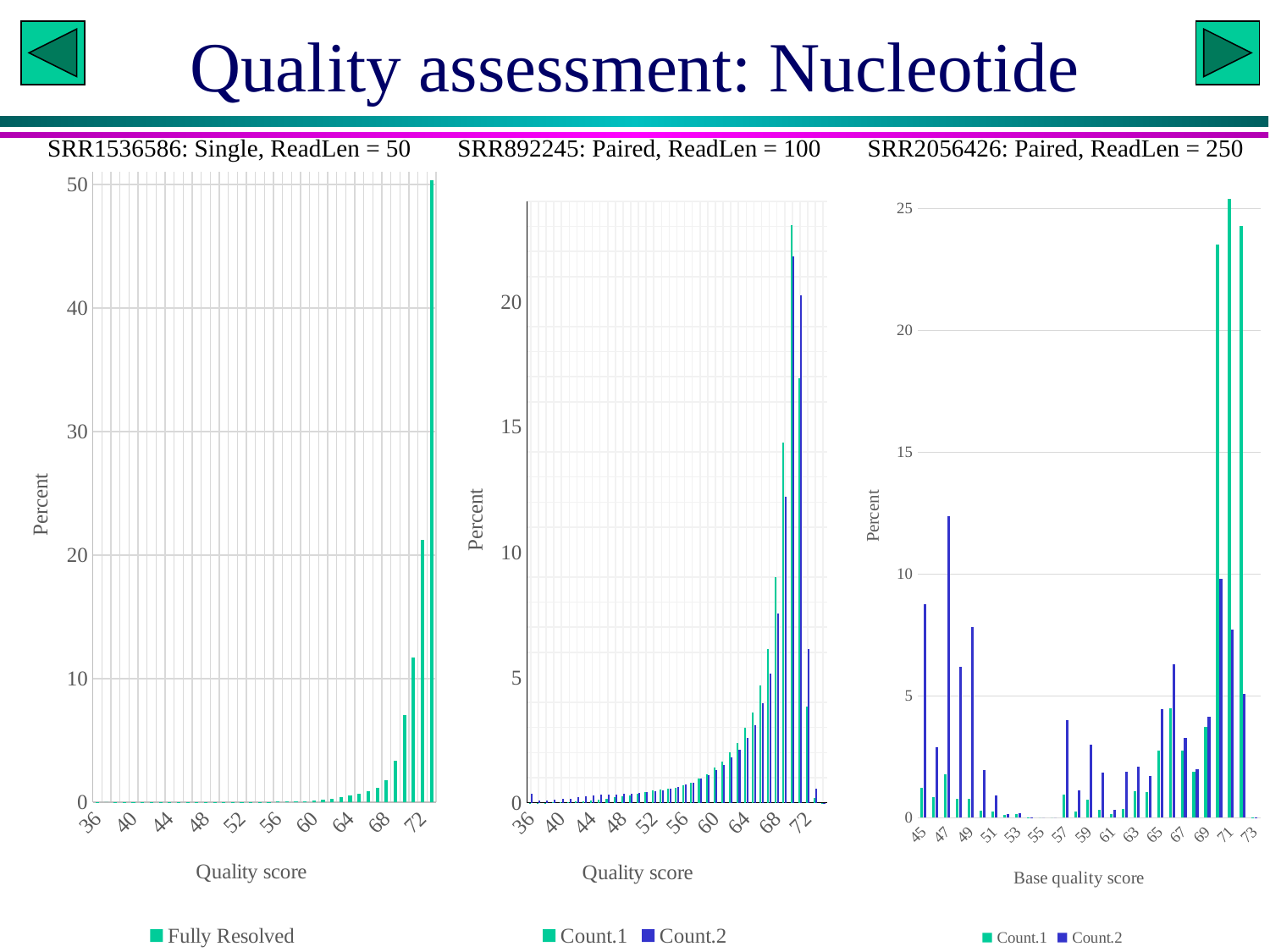
What kind of chart is the SRR1536586: Single, ReadLen = 50 chart? bar chart How many series does the legend of the SRR892245: Paired, ReadLen = 100 chart list? 2 What are the legend entries of the SRR2056426: Paired, ReadLen = 250 chart? Count.1 and Count.2 In the SRR1536586: Single, ReadLen = 50 chart, is the tallest bar greater or less than 40? greater In the SRR2056426: Paired, ReadLen = 250 chart, is the Count.2 value at quality score 47 greater or less than 10? greater In the SRR1536586: Single, ReadLen = 50 chart, do the bar values generally rise or fall as the quality score increases? rise In the SRR2056426: Paired, ReadLen = 250 chart, is the Count.2 value at quality score 45 greater or less than 10? less How many series does the legend of the SRR1536586: Single, ReadLen = 50 chart list? 1 What is the x-axis title of the SRR2056426: Paired, ReadLen = 250 chart? Base quality score In the SRR2056426: Paired, ReadLen = 250 chart, which series has the tallest bar overall, Count.1 or Count.2? Count.1